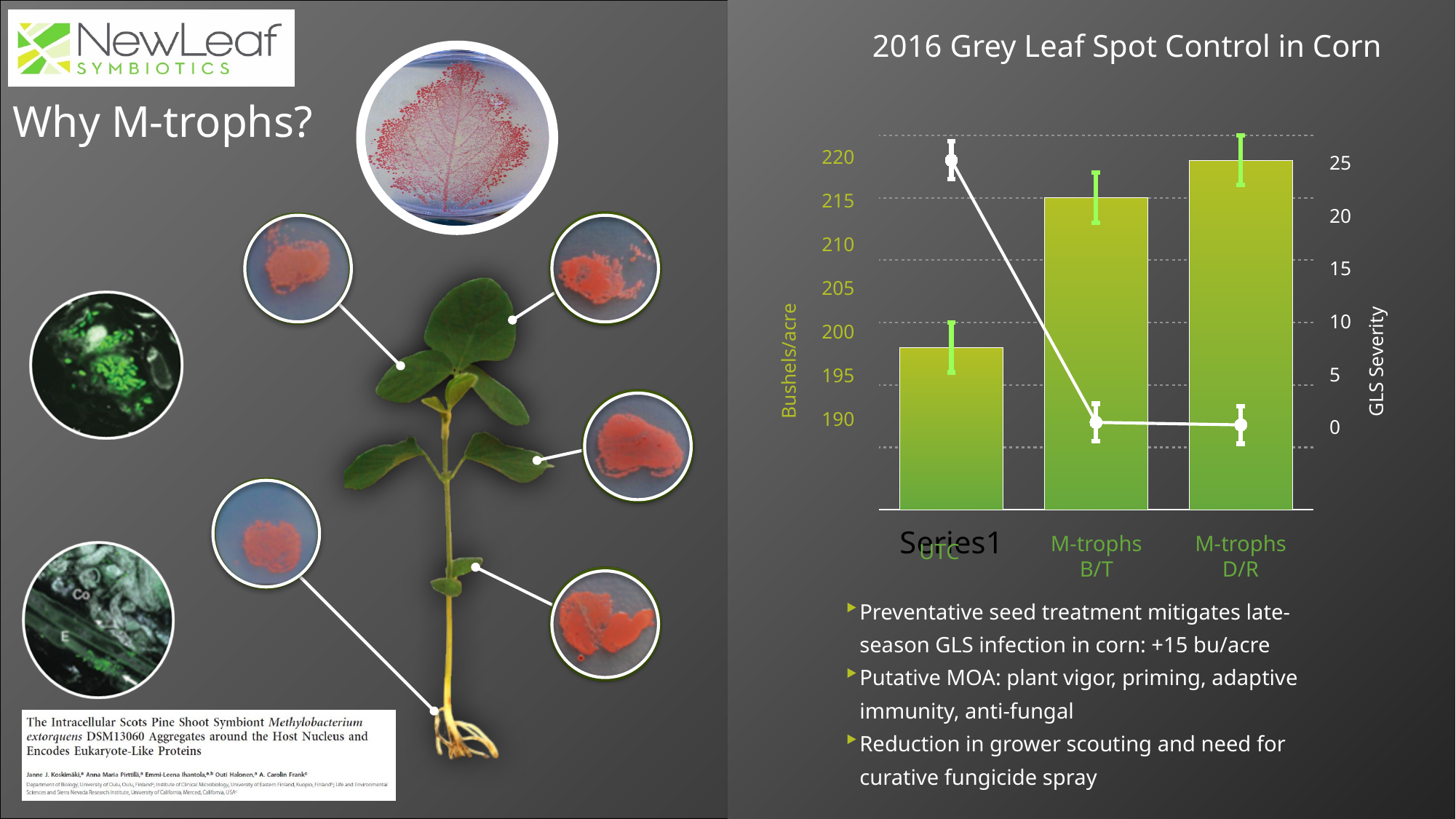
How many treatment categories are shown on the x axis of the chart? 3 Do the bushels/acre bars rise or fall from UTC to M-trophs D/R? rise What is the label of the right-hand vertical axis of the chart? GLS Severity Which has the larger bushels/acre bar, UTC or M-trophs B/T? M-trophs B/T Is the bushels/acre bar for UTC greater or less than 200? less Which treatment has the highest GLS Severity on the line? UTC What is the title of the chart on the slide? 2016 Grey Leaf Spot Control in Corn Is the GLS Severity value for UTC greater or less than 20? greater Is the GLS Severity value for M-trophs B/T greater or less than 5? less Which treatment has the highest bar for bushels per acre? M-trophs D/R Which treatment has the lowest bar for bushels per acre? UTC